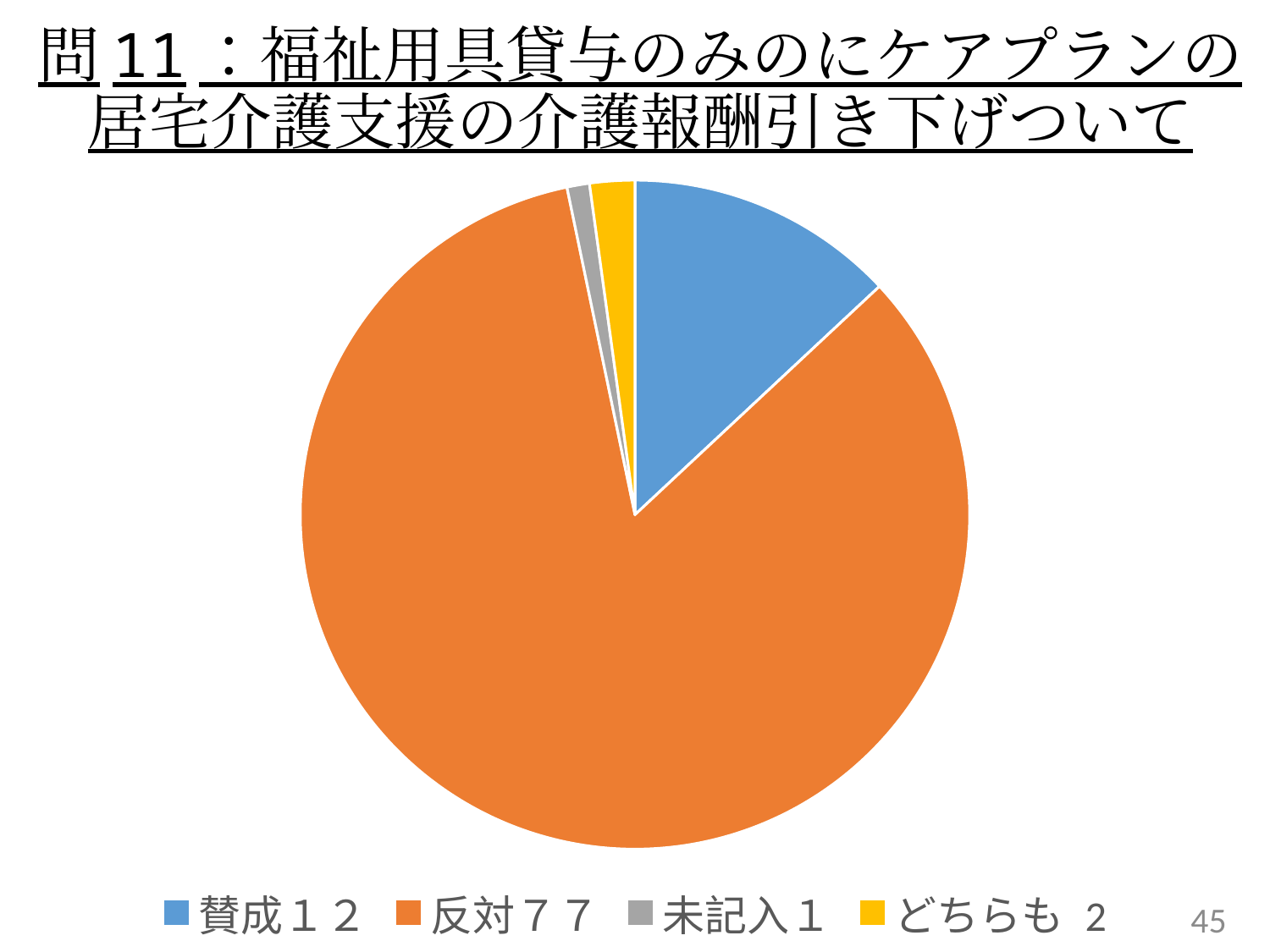
How many categories does the pie chart have? 4 What is the value for 反対 in the pie chart? ７７ What is the value for 未記入 in the pie chart? １ What is the total of all the values shown in the pie chart legend? 92 What colour is the slice for 反対 in the pie chart? orange What is the value for どちらも in the pie chart? 2 What is the difference between the values for 反対 and 賛成? 65 Which category has the largest slice of the pie chart? 反対 What kind of chart is shown on the slide? pie chart What is the value for 賛成 in the pie chart? １２ Which is larger, the value for 賛成 or the value for どちらも? 賛成 Which category has the smallest slice of the pie chart? 未記入